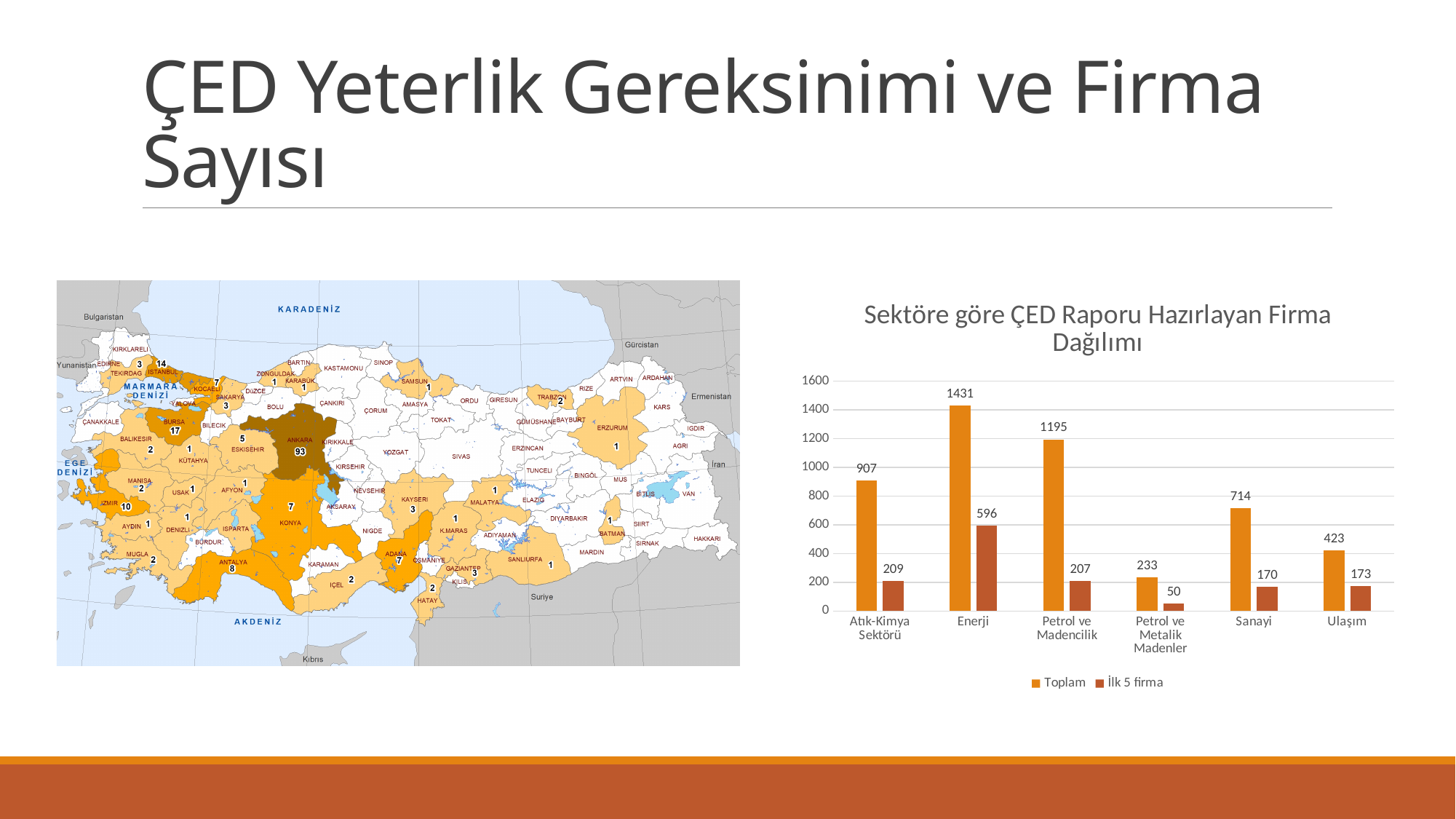
What is the Toplam value for Enerji in the bar chart? 1431 How many series does the legend of the bar chart list? 2 Which category has the highest Toplam value in the bar chart? Enerji What is the title of the bar chart? Sektöre göre ÇED Raporu Hazırlayan Firma Dağılımı How many categories are shown on the x axis of the bar chart? 6 What is the difference between the Toplam and İlk 5 firma values for Sanayi in the bar chart? 544 Which category has the lowest İlk 5 firma value in the bar chart? Petrol ve Metalik Madenler What are the two series names listed in the legend of the bar chart? Toplam and İlk 5 firma What is the İlk 5 firma value for Petrol ve Madencilik in the bar chart? 207 In the bar chart, which is larger: the Toplam value for Atık-Kimya Sektörü or the Toplam value for Sanayi? Atık-Kimya Sektörü What kind of chart is shown on the right side of the slide? Bar chart What is the Toplam value for Ulaşım in the bar chart? 423